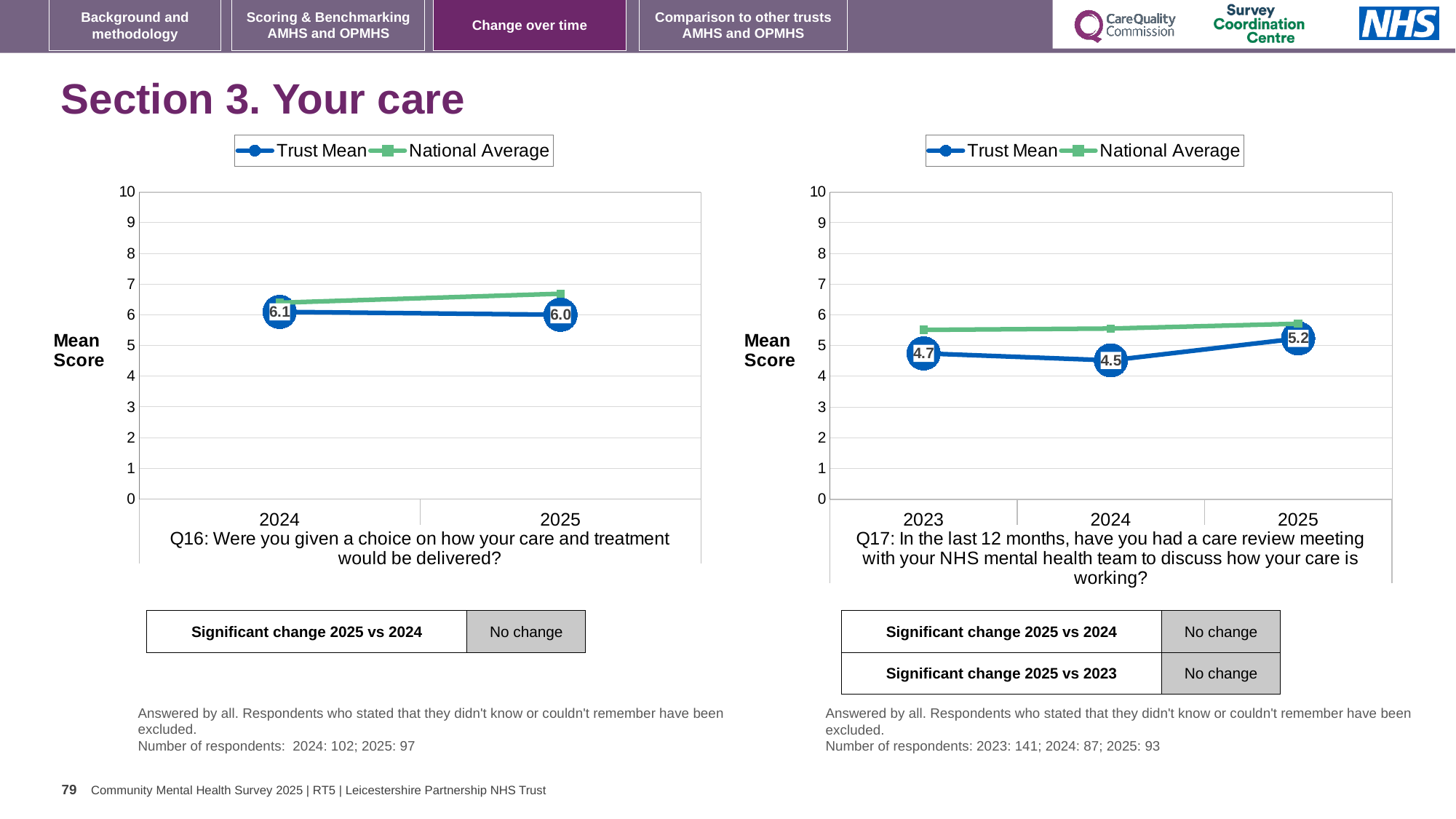
In the Q17 chart on the right, what is the Trust Mean for 2025? 5.2 In the Q17 chart on the right, what is the difference between the Trust Mean for 2025 and the Trust Mean for 2024? 0.7 In the Q17 chart on the right, which year has the highest Trust Mean? 2025 In the Q17 chart on the right, is the National Average for 2025 greater or less than 5? greater In the Q17 chart on the right, how many series does the legend list? 2 In the Q17 chart on the right, what is the Trust Mean for 2023? 4.7 In the Q17 chart on the right, which year has the lowest Trust Mean? 2024 In the Q16 chart on the left, what is the Trust Mean for 2024? 6.1 In the Q16 chart on the left, how many years are shown on the x axis? 2 In the Q16 chart on the left, which is larger in 2025, the Trust Mean or the National Average? National Average What type of chart is the Q16 chart on the left? Line chart In the Q16 chart on the left, what is the Trust Mean for 2025? 6.0